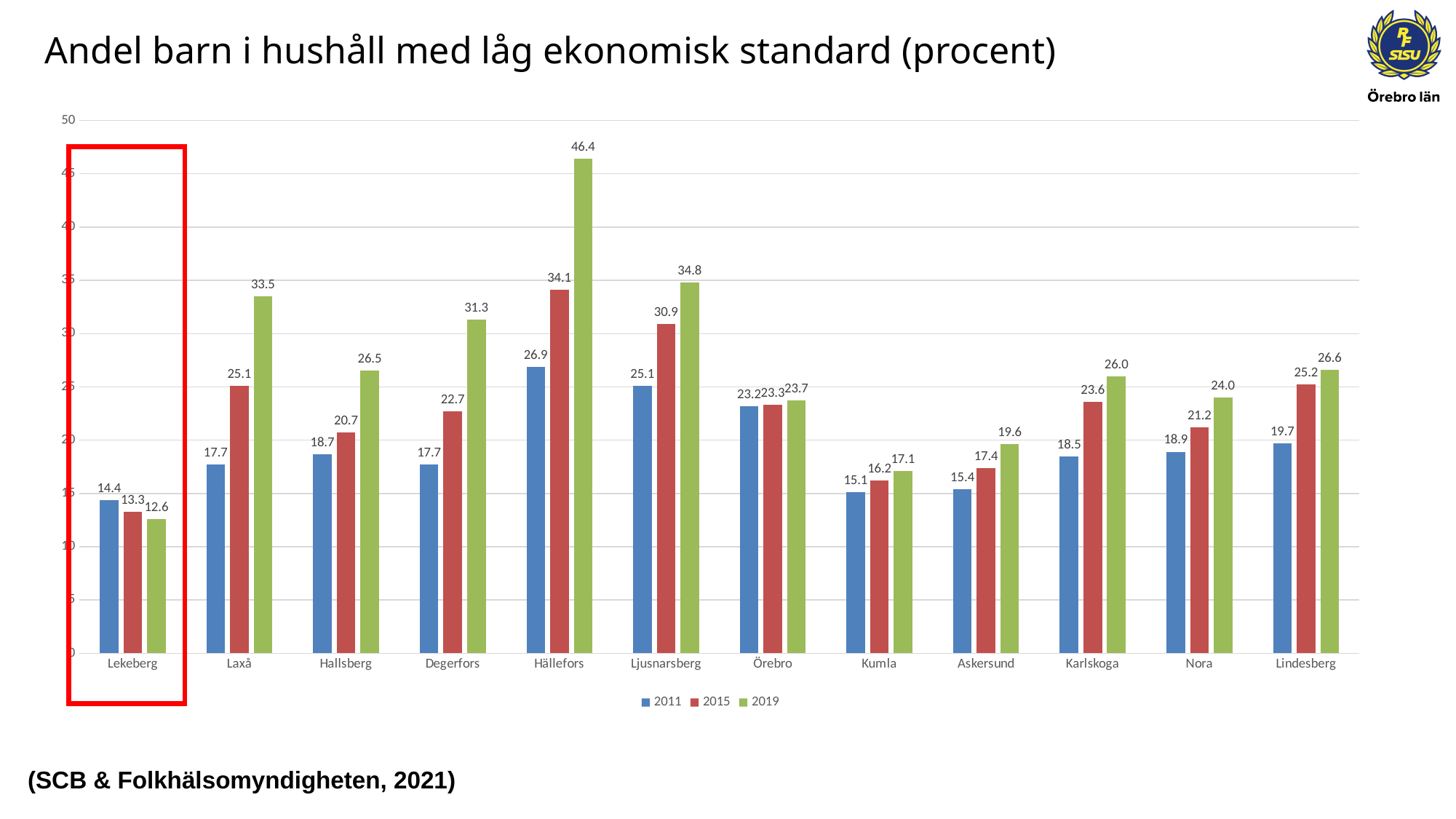
What is the value for Hällefors in 2019? 46.4 Which municipality is highlighted with a red box? Lekeberg How many series does the legend list? 3 What is the difference between the 2019 and 2011 values for Laxå? 15.8 Do the values for Lekeberg rise or fall from 2011 to 2019? fall Which municipality has the highest value in 2019? Hällefors What is the value for Kumla in 2015? 16.2 What kind of chart is shown on the slide? bar chart What is the value for Lekeberg in 2011? 14.4 Which is larger, the 2019 value for Ljusnarsberg or the 2019 value for Degerfors? Ljusnarsberg Which municipality has the lowest value in 2019? Lekeberg How many municipalities are shown on the x axis? 12